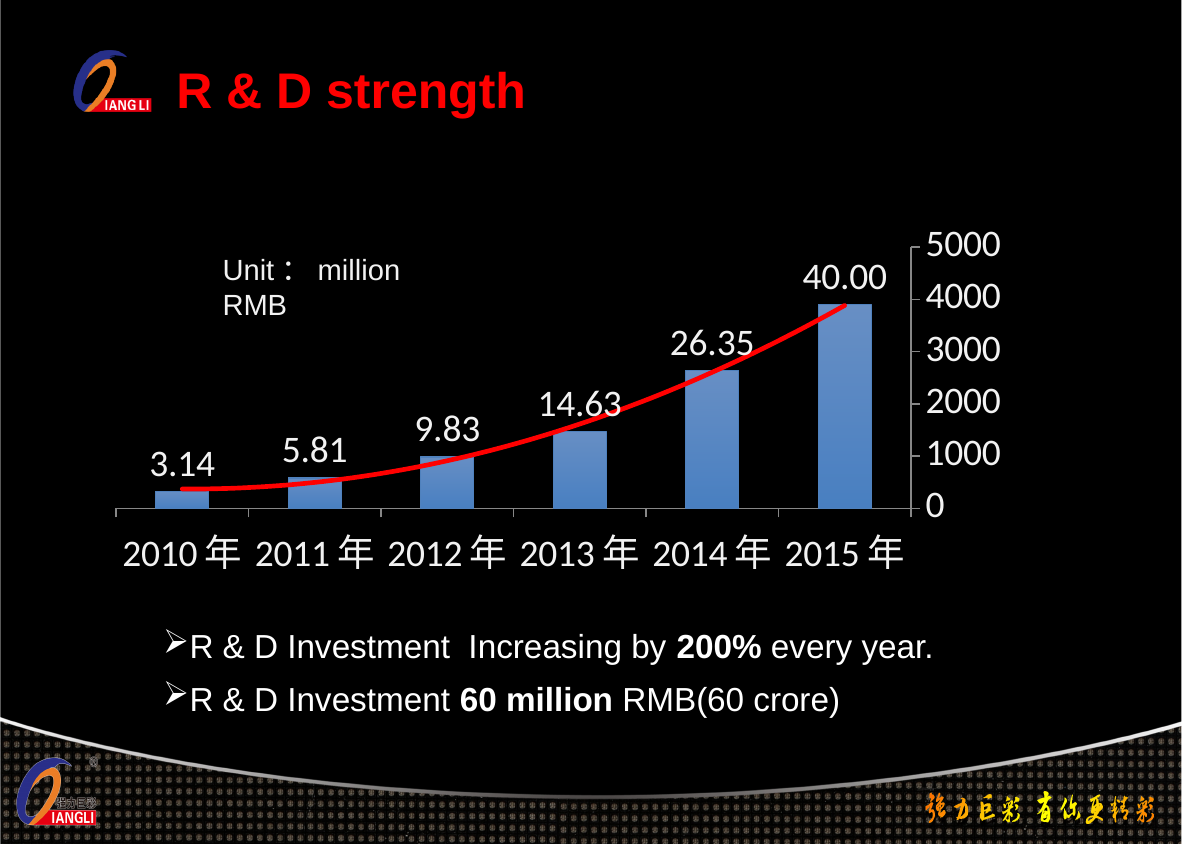
Which is larger, the value for 2013 or the value for 2012? 2013 What is the value labelled on the bar for 2010? 3.14 How many years are shown on the x axis of the chart? 6 What is the value labelled on the bar for 2012? 9.83 Do the values rise or fall from 2010 to 2015? Rise Which year has the lowest value in the chart? 2010 What is the R&D investment value shown for 2015? 40.00 Which year has the highest value in the chart? 2015 What is the difference between the values for 2011 and 2010? 2.67 What is the value labelled on the bar for 2014? 26.35 What is the difference between the values for 2015 and 2014? 13.65 What kind of chart is shown on the slide? Bar chart